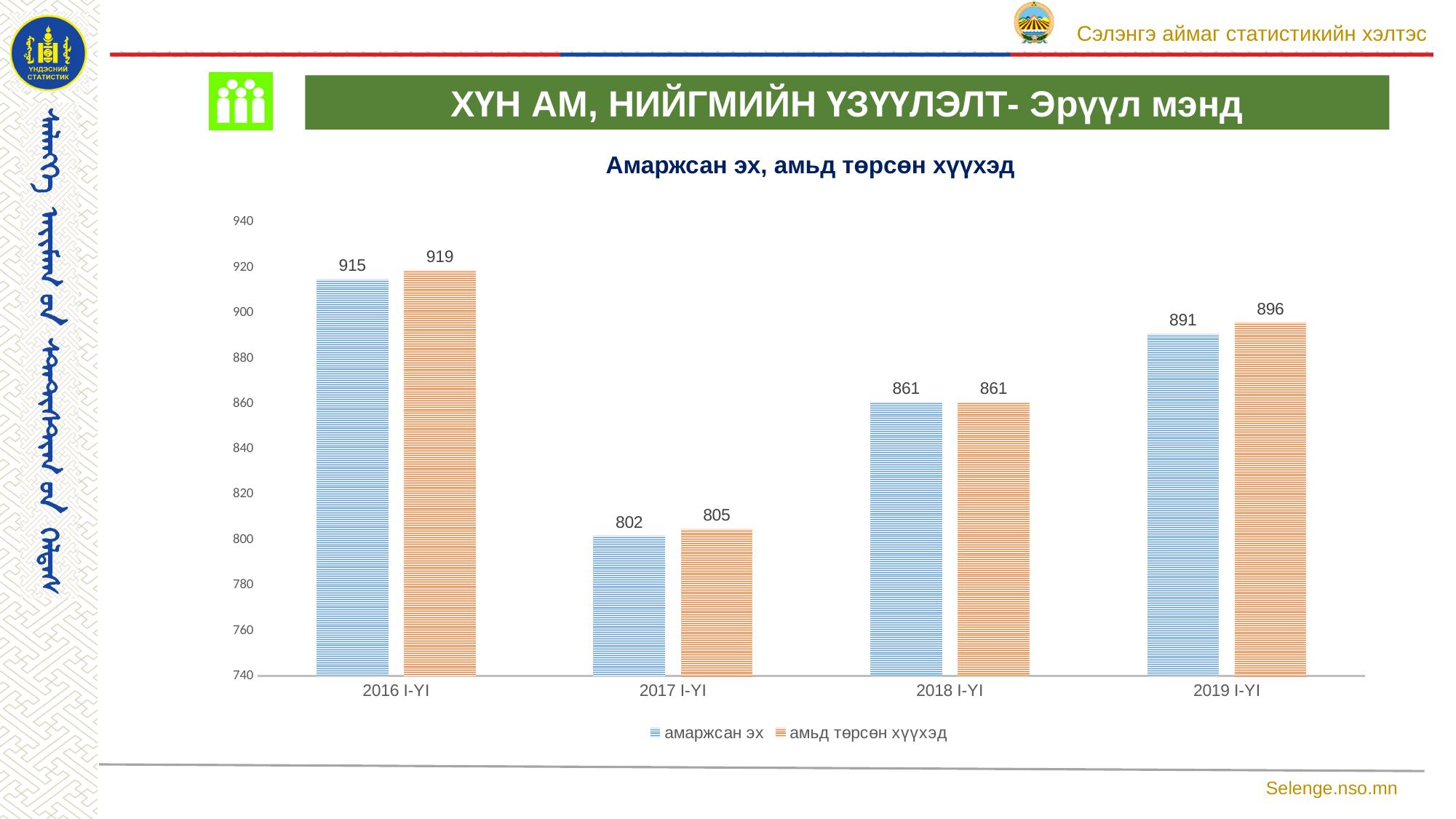
What kind of chart is shown on the slide? Bar chart How many periods are shown on the x axis? 4 Which period has the highest value for амьд төрсөн хүүхэд? 2016 I-YI What is the difference between the амаржсан эх values for 2016 I-YI and 2017 I-YI? 113 Which period has the lowest value for амаржсан эх? 2017 I-YI What is the value for амаржсан эх in 2016 I-YI? 915 What is the value for амаржсан эх in 2017 I-YI? 802 Which is larger: амаржсан эх in 2018 I-YI or амаржсан эх in 2019 I-YI? 2019 I-YI What is the title of the chart? Амаржсан эх, амьд төрсөн хүүхэд What is the difference between амьд төрсөн хүүхэд and амаржсан эх in 2019 I-YI? 5 What is the value for амьд төрсөн хүүхэд in 2019 I-YI? 896 How many series does the legend list? 2